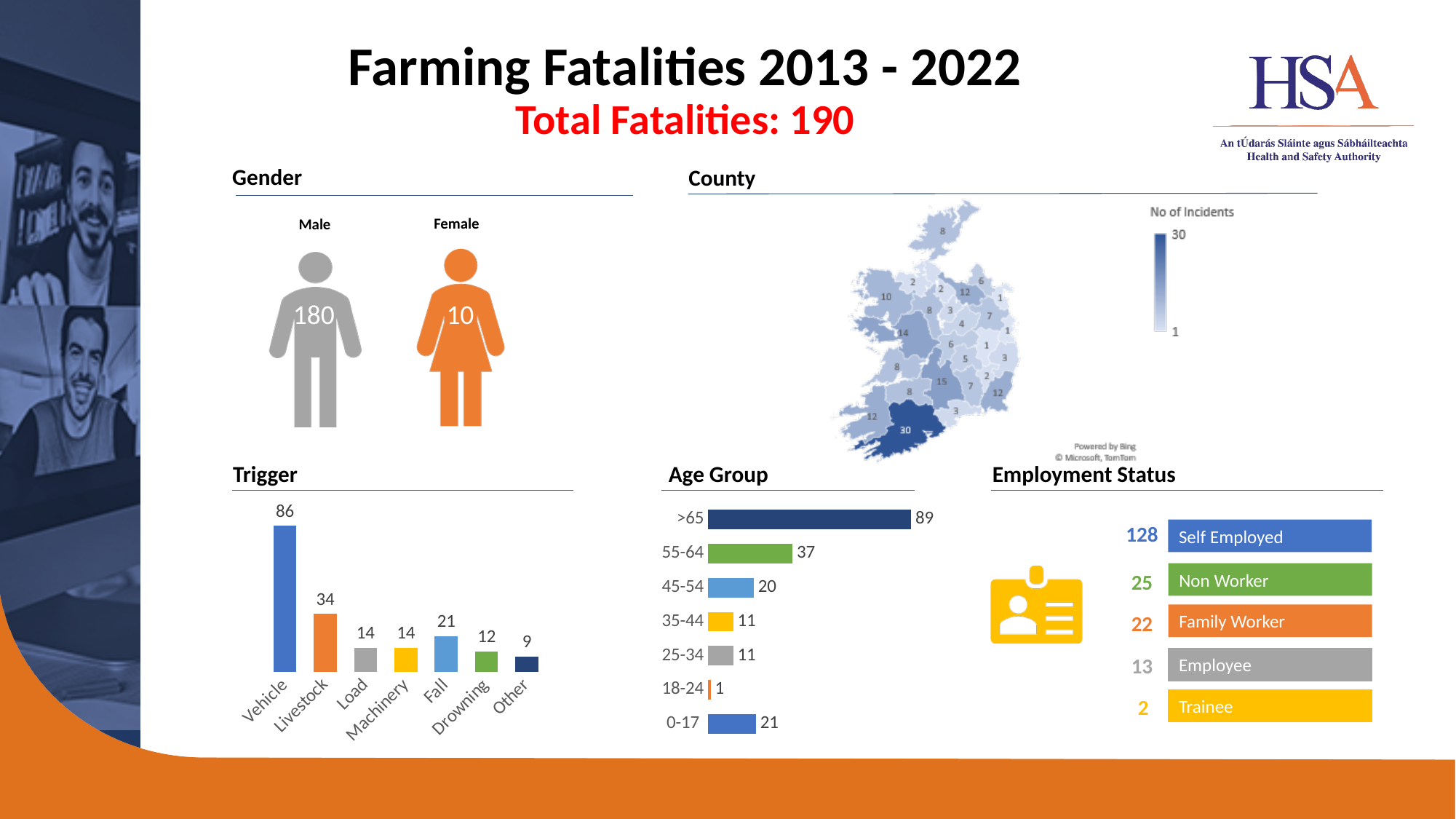
In the Age Group chart, what is the value for 55-64? 37 In the Trigger chart, how many trigger categories are shown? 7 In the Employment Status chart, what is the value for Family Worker? 22 In the Age Group chart, which age group has the lowest value? 18-24 In the Trigger chart, what is the value for Vehicle? 86 In the Age Group chart, how many age groups are shown? 7 In the Age Group chart, what is the difference between >65 and 0-17? 68 What kind of chart is the Age Group chart? Bar chart In the Trigger chart, which trigger has the lowest value? Other In the Trigger chart, which is larger, Fall or Drowning? Fall In the Age Group chart, which age group has the highest value? >65 In the Trigger chart, what is the difference between Vehicle and Livestock? 52